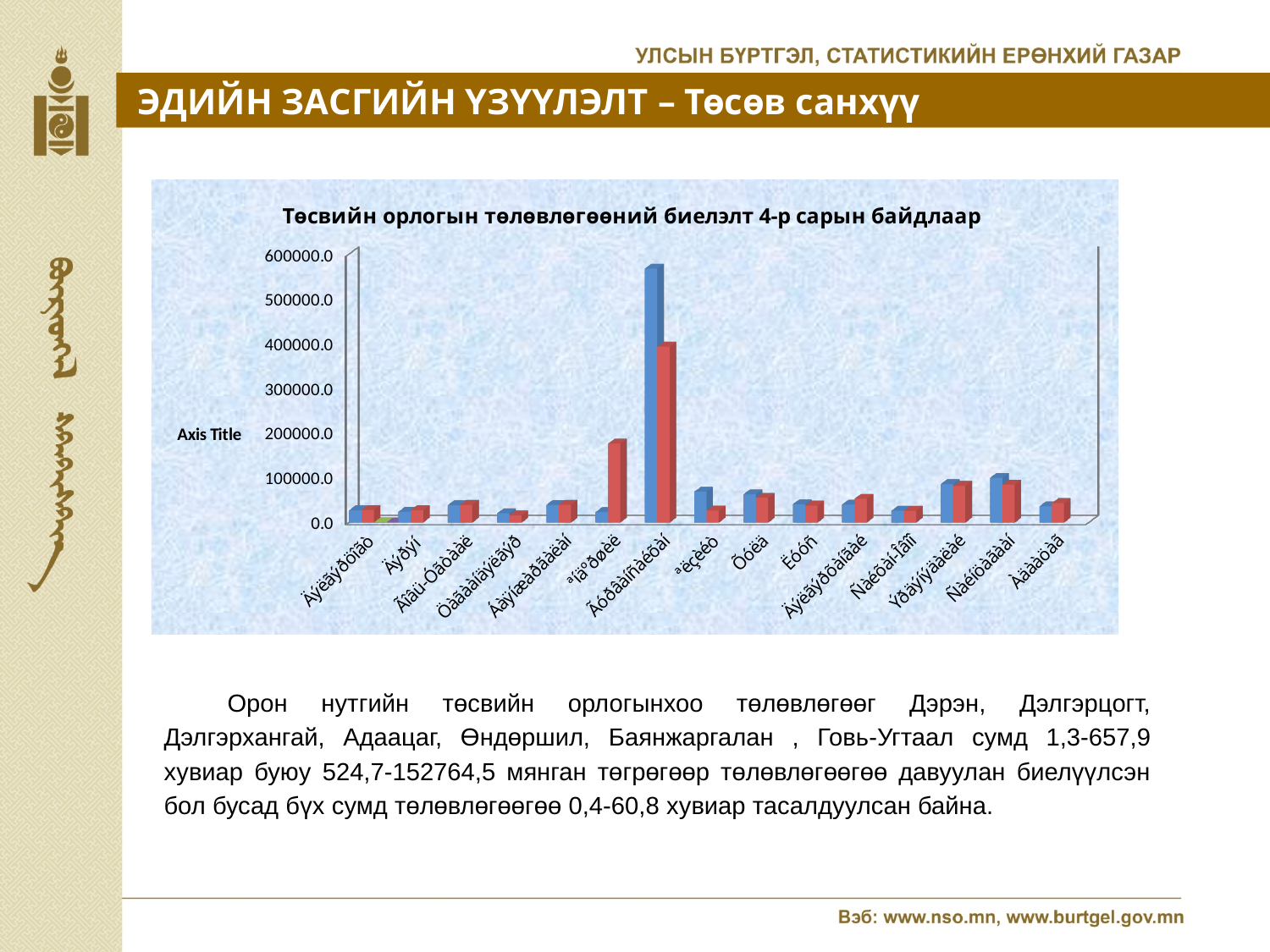
Is the tallest blue bar in the chart greater or less than 500000? greater What is the highest tick value shown on the vertical axis of the chart? 600000.0 Is the red bar in the sixth category from the left greater or less than 100000? greater Is the tallest red bar in the chart greater or less than 300000? greater How many categories are plotted along the x axis of the chart? 15 Which category from the left has the tallest bar in the chart? the seventh category from the left In the sixth category from the left, which bar is taller, the blue one or the red one? the red one In the seventh category from the left, which bar is taller, the blue one or the red one? the blue one What kind of chart is shown on the slide? bar chart What is the title of the chart? Төсвийн орлогын төлөвлөгөөний биелэлт 4-р сарын байдлаар What is the label shown on the vertical axis of the chart? Axis Title